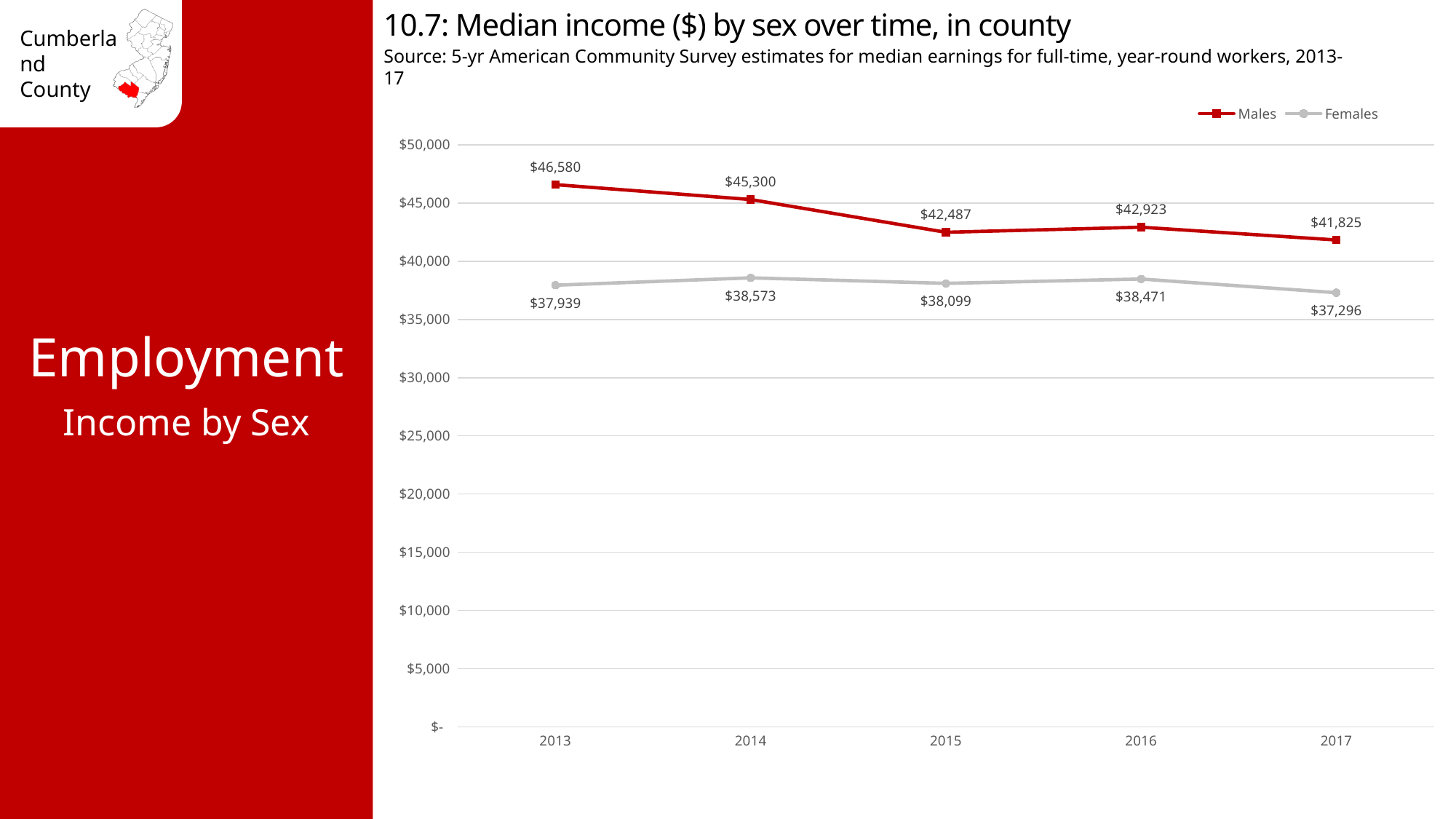
How many series does the legend list? 2 What is the difference between the Males and Females median income in 2016? $4,452 What is the median income for Males in 2013? $46,580 Is the median income for Females in 2015 greater or less than $40,000? less In which year is the median income for Males highest? 2013 What is the median income for Females in 2014? $38,573 What kind of chart is shown on the slide? line chart What is the median income for Females in 2017? $37,296 Does the median income for Males generally rise or fall from 2013 to 2017? fall How many years are shown on the x axis? 5 In which year is the median income for Females lowest? 2017 Which is larger, the Males median income in 2015 or in 2016? 2016